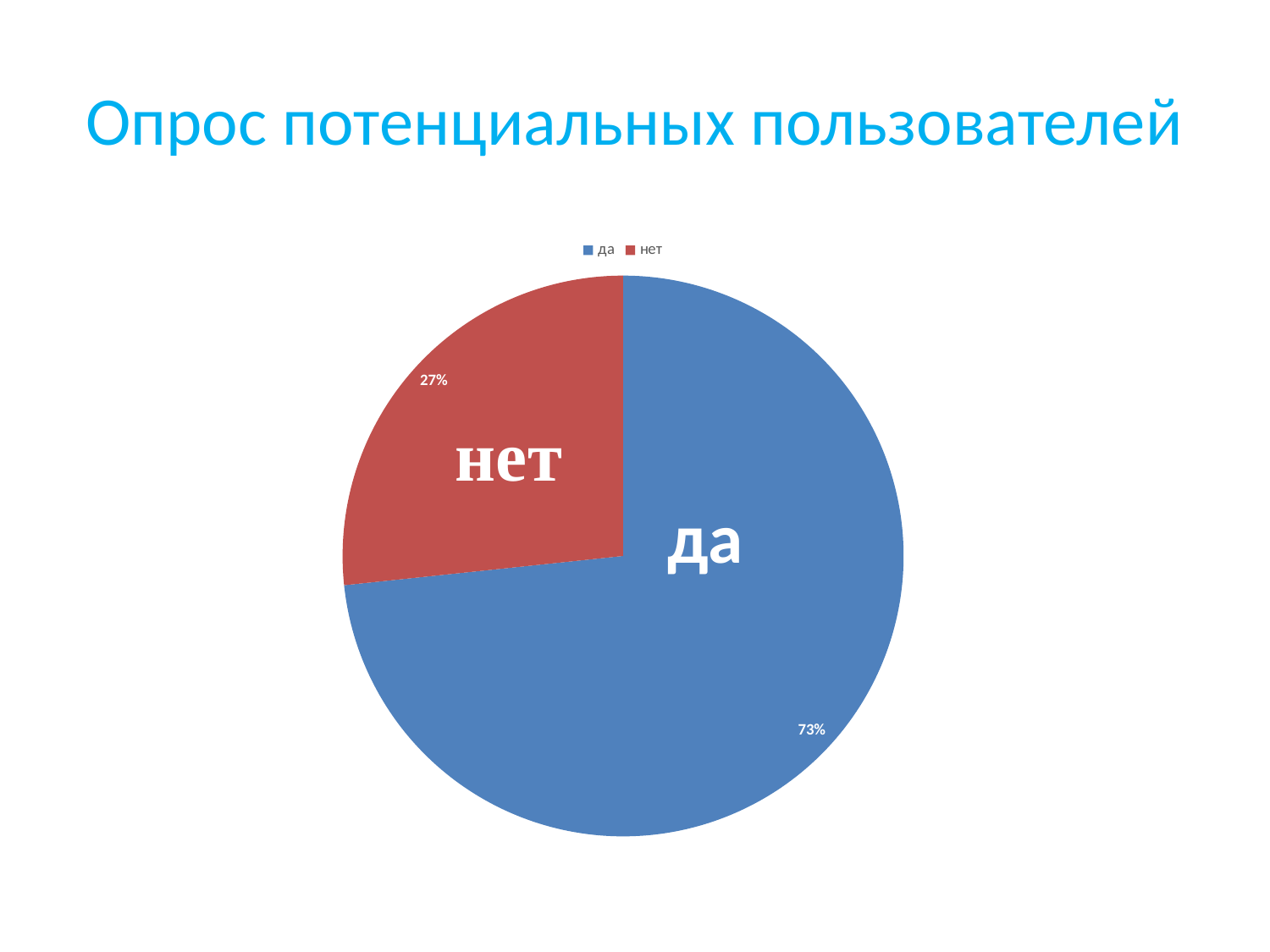
What kind of chart is shown on the slide? pie chart What percentage of the pie is labelled "да"? 73% Which slice of the pie is the largest? да What share of the pie does the "да" slice represent? 73% What percentage of the pie is labelled "нет"? 27% How many slices does the pie chart have? 2 What is the difference in percentage points between the "да" and "нет" slices? 46 Which slice is larger, "да" or "нет"? да What colour is the "нет" slice of the pie? red Which slice of the pie is the smallest? нет What is the title of the slide containing the pie chart? Опрос потенциальных пользователей How many entries does the legend list? 2